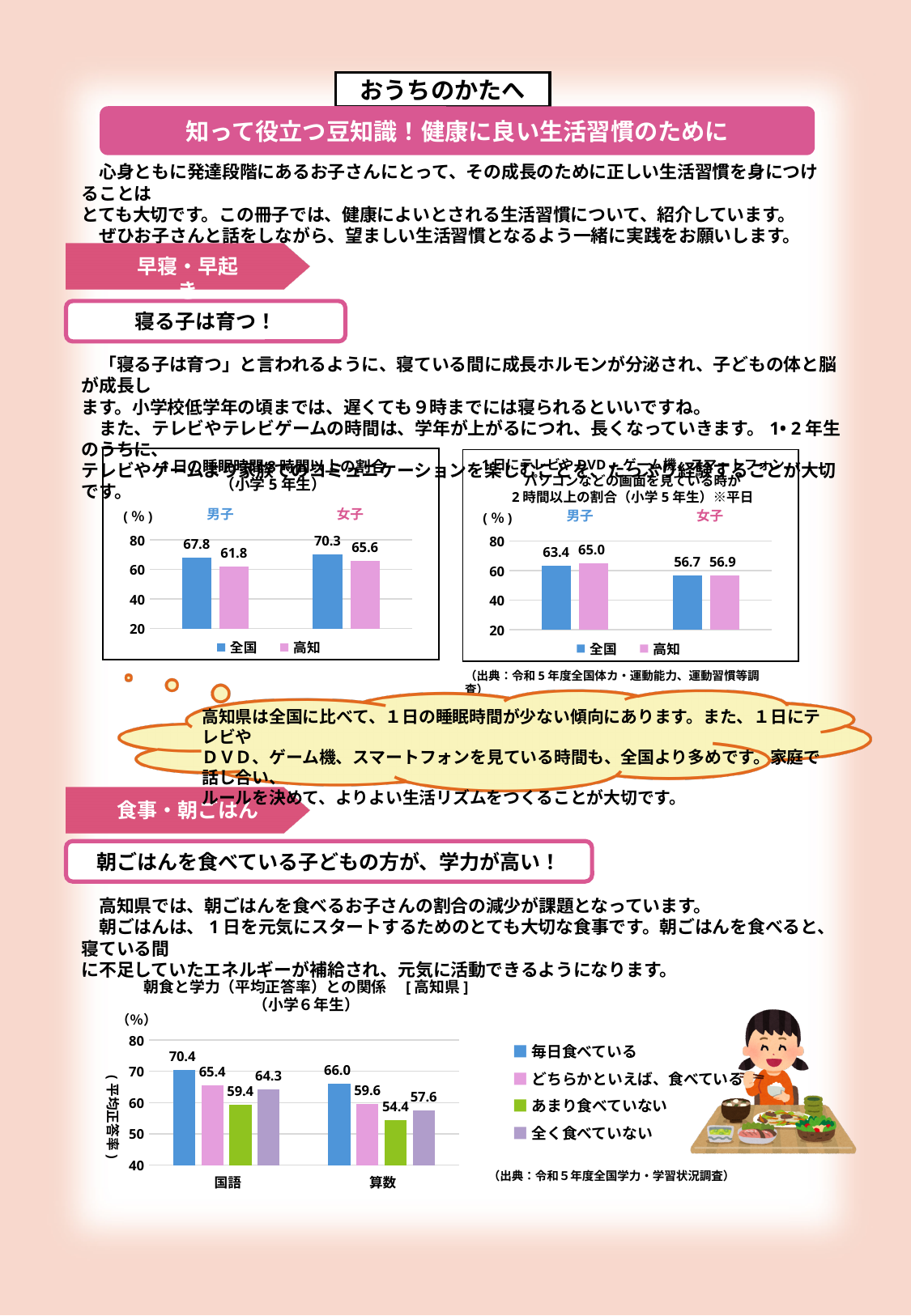
In the bottom chart (朝食と学力), what is the value for あまり食べていない in 算数? 54.4 In the bottom chart (朝食と学力), what is the value for 毎日食べている in 国語? 70.4 What kind of chart is the bottom chart (朝食と学力)? Bar chart In the bottom chart (朝食と学力), which group has the lowest value in 国語? あまり食べていない In the top-right chart (screen time 2 hours or more, grade 5), how many series does the legend list? 2 In the top-right chart (screen time 2 hours or more, grade 5), what is the value for 全国 for 女子? 56.7 In the top-left chart (sleep 8 hours or more, grade 5), which is larger for 女子, 全国 or 高知? 全国 In the top-left chart (sleep 8 hours or more, grade 5), what is the value for 全国 for 男子? 67.8 In the top-left chart (sleep 8 hours or more, grade 5), what is the difference between 全国 and 高知 for 男子? 6.0 In the top-left chart (sleep 8 hours or more, grade 5), what is the value for 高知 for 女子? 65.6 In the bottom chart (朝食と学力), what is the difference between 毎日食べている and 全く食べていない in 算数? 8.4 In the top-right chart (screen time 2 hours or more, grade 5), what is the value for 高知 for 男子? 65.0